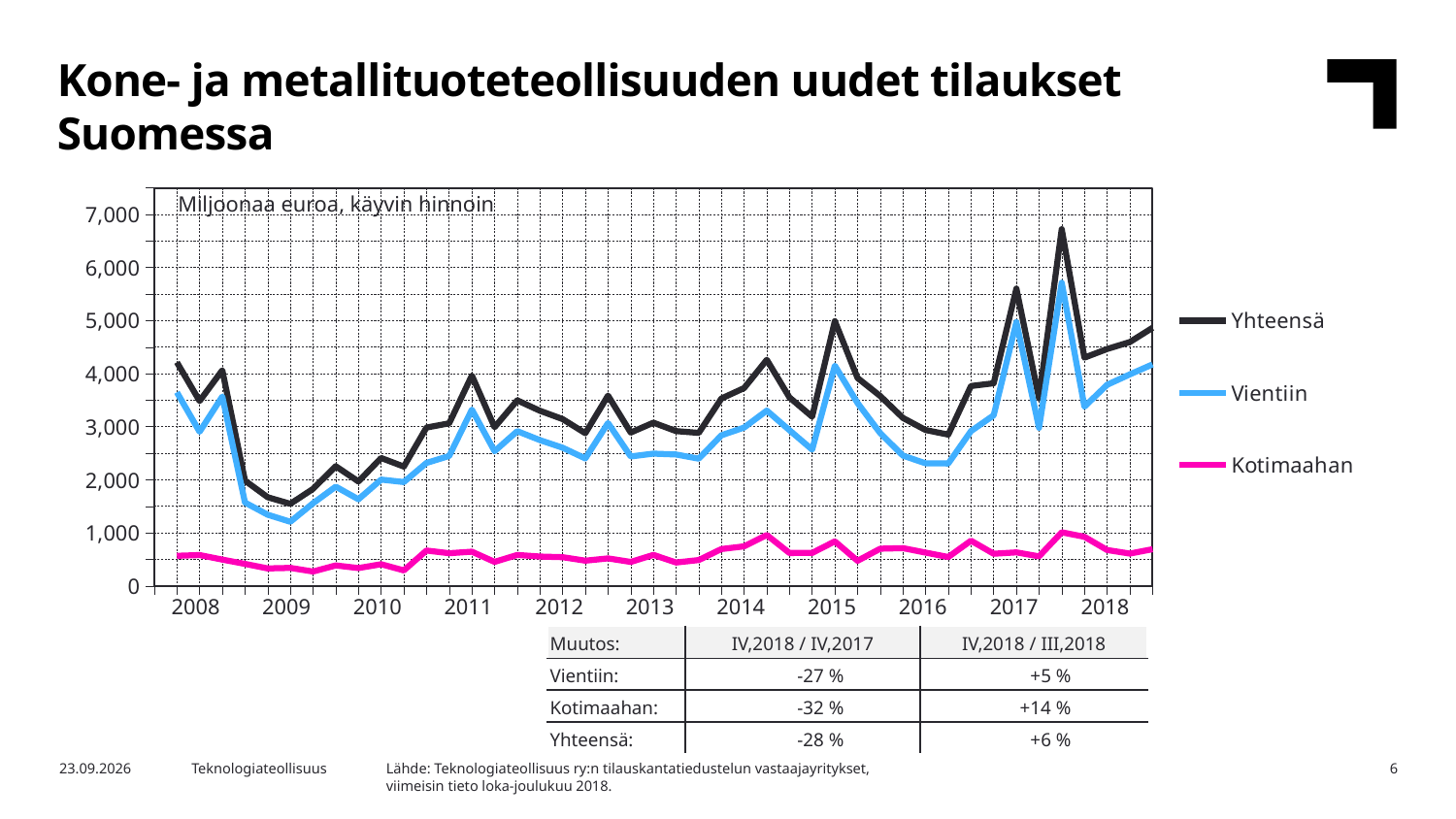
Which series has the highest values throughout the chart? Yhteensä Is the value of the Kotimaahan line at the end of 2018 greater or less than 1,000? less What unit label is printed inside the chart area? Miljoonaa euroa, käyvin hinnoin Is the lowest point of the Yhteensä line in 2009 greater or less than 2,000? less How many series does the chart legend list? 3 In which year does the Yhteensä line reach its highest peak? 2017 What kind of chart is shown on the slide? line chart Which is larger at the start of 2008, the Vientiin value or the Kotimaahan value? Vientiin Is the highest peak of the Yhteensä line greater or less than 6,000? greater Does the Yhteensä line rise or fall from 2008 to 2009? fall Which series has the lowest values throughout the chart? Kotimaahan What is the title of the chart on the slide? Kone- ja metallituoteteollisuuden uudet tilaukset Suomessa